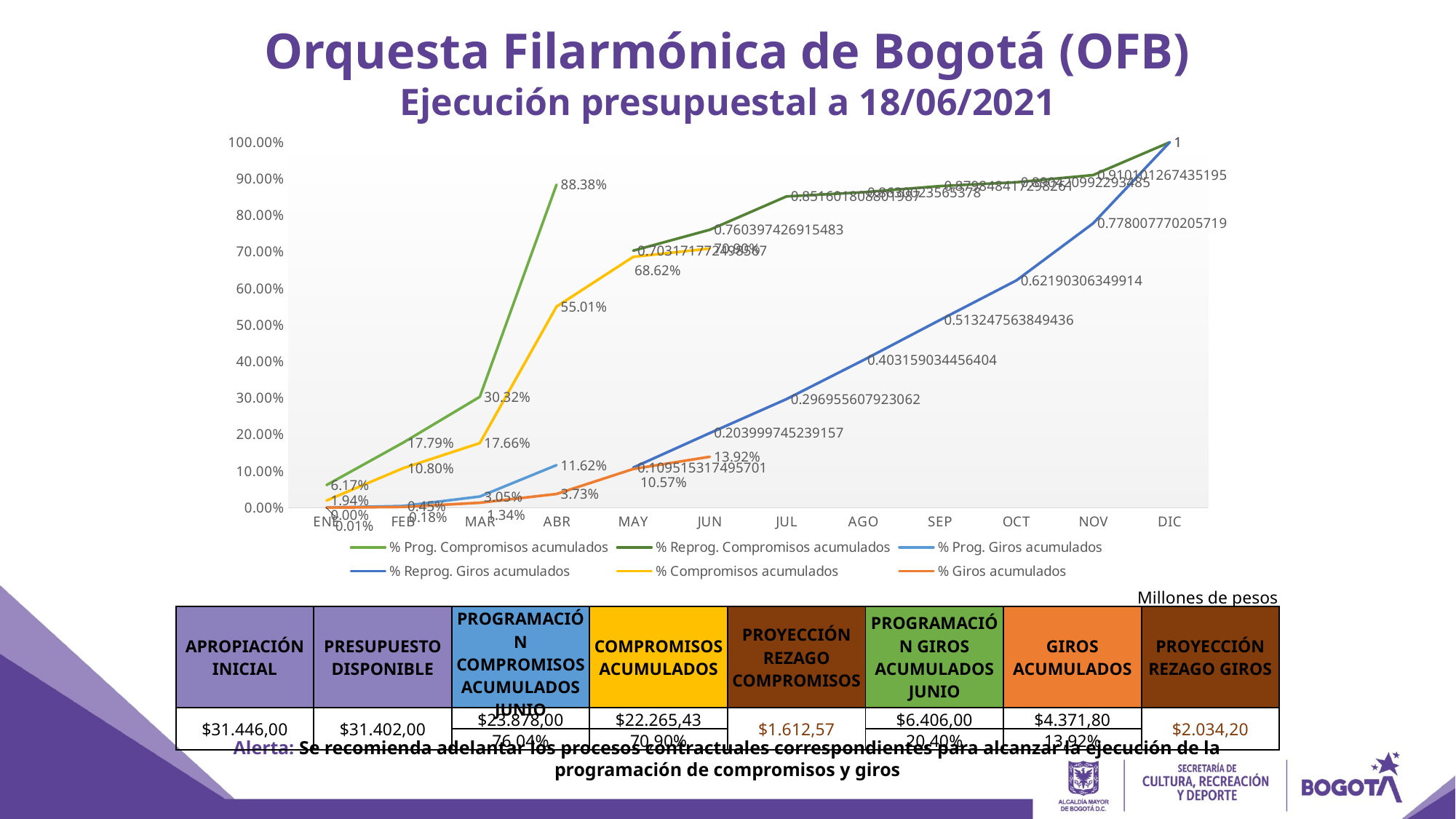
What type of chart is shown on the slide? line chart How many series does the chart legend list? 6 What is the value of % Compromisos acumulados in JUN? 70.90% In ABR, which is higher: % Prog. Compromisos acumulados or % Compromisos acumulados? % Prog. Compromisos acumulados What is the value of % Prog. Compromisos acumulados in ABR? 88.38% What is the value of % Giros acumulados in JUN? 13.92% Is the value of % Reprog. Giros acumulados in NOV greater or less than 70.00%? greater Does the % Giros acumulados series rise or fall from ENE to JUN? rises How many months are shown along the x axis of the chart? 12 What is the value of % Prog. Giros acumulados in ABR? 11.62% What is the difference between the % Compromisos acumulados values in ABR and MAR? 37.35% In which month does % Compromisos acumulados reach its highest labelled value? JUN